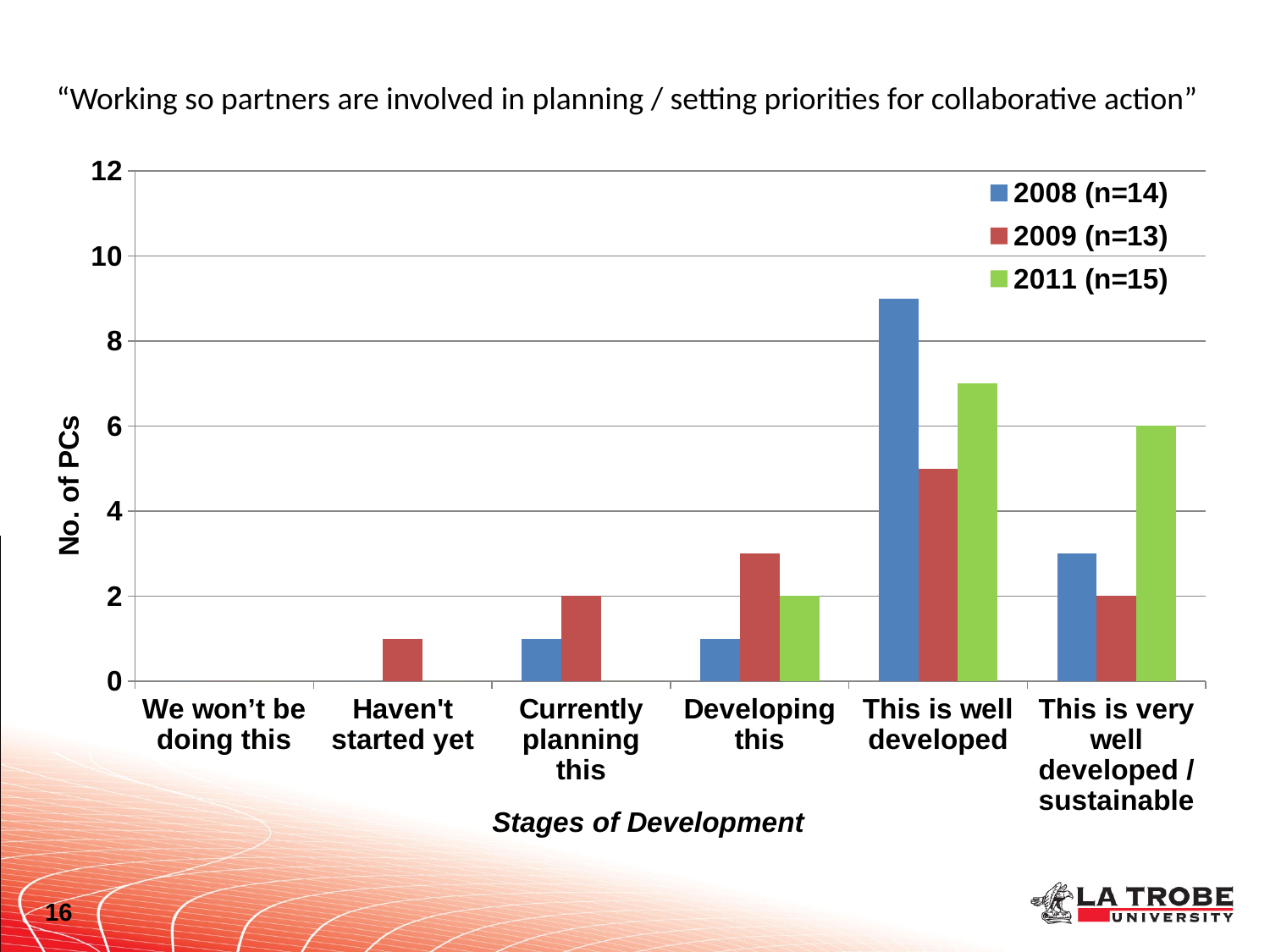
At 'This is very well developed / sustainable', which series has the larger value, 2008 (n=14) or 2011 (n=15)? 2011 (n=15) How many stages of development are shown on the x axis? 6 What is the label of the y axis? No. of PCs How many series does the legend list? 3 Which stage of development has the highest value for 2008 (n=14)? This is well developed What is the value for 2009 (n=13) at 'Currently planning this'? 2 What kind of chart is shown on the slide? bar chart What is the value for 2011 (n=15) at 'Developing this'? 2 Is the value for 2008 (n=14) at 'This is well developed' greater or less than 8? greater What is the value for 2009 (n=13) at 'This is very well developed / sustainable'? 2 What is the value for 2011 (n=15) at 'This is very well developed / sustainable'? 6 Is the value for 2009 (n=13) at 'This is well developed' greater or less than 6? less